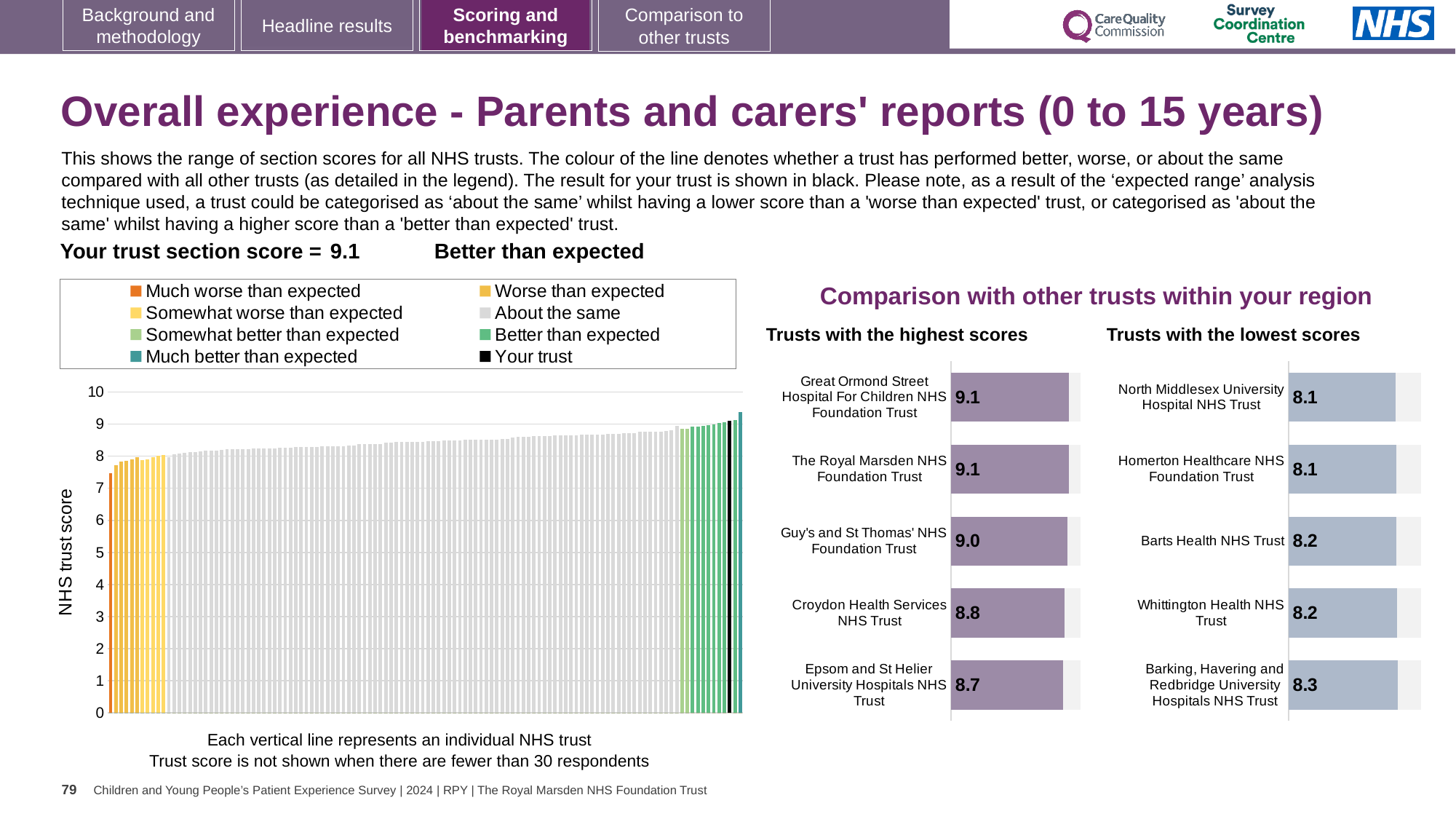
In the 'Trusts with the lowest scores' chart, what is the score for Barking, Havering and Redbridge University Hospitals NHS Trust? 8.3 In the 'Trusts with the highest scores' chart, what is the difference between the scores of Great Ormond Street Hospital For Children NHS Foundation Trust and Epsom and St Helier University Hospitals NHS Trust? 0.4 In the 'Trusts with the highest scores' chart, which trust has the lowest score? Epsom and St Helier University Hospitals NHS Trust In the large 'NHS trust score' chart on the left, do the bar values rise or fall from left to right along the x axis? rise In the 'Trusts with the highest scores' chart, what is the score for Croydon Health Services NHS Trust? 8.8 In the large 'NHS trust score' chart on the left, is the value of the leftmost (orange) bar greater or less than 8? less How many trusts are shown in the 'Trusts with the highest scores' chart? 5 In the 'Trusts with the highest scores' chart, what is the score for Guy's and St Thomas' NHS Foundation Trust? 9.0 In the 'Trusts with the lowest scores' chart, which trust has the highest score? Barking, Havering and Redbridge University Hospitals NHS Trust In the 'Trusts with the lowest scores' chart, which has the larger score: Barts Health NHS Trust or Barking, Havering and Redbridge University Hospitals NHS Trust? Barking, Havering and Redbridge University Hospitals NHS Trust How many entries does the legend of the large 'NHS trust score' chart on the left list? 8 In the 'Trusts with the lowest scores' chart, what is the difference between the scores of Barking, Havering and Redbridge University Hospitals NHS Trust and North Middlesex University Hospital NHS Trust? 0.2